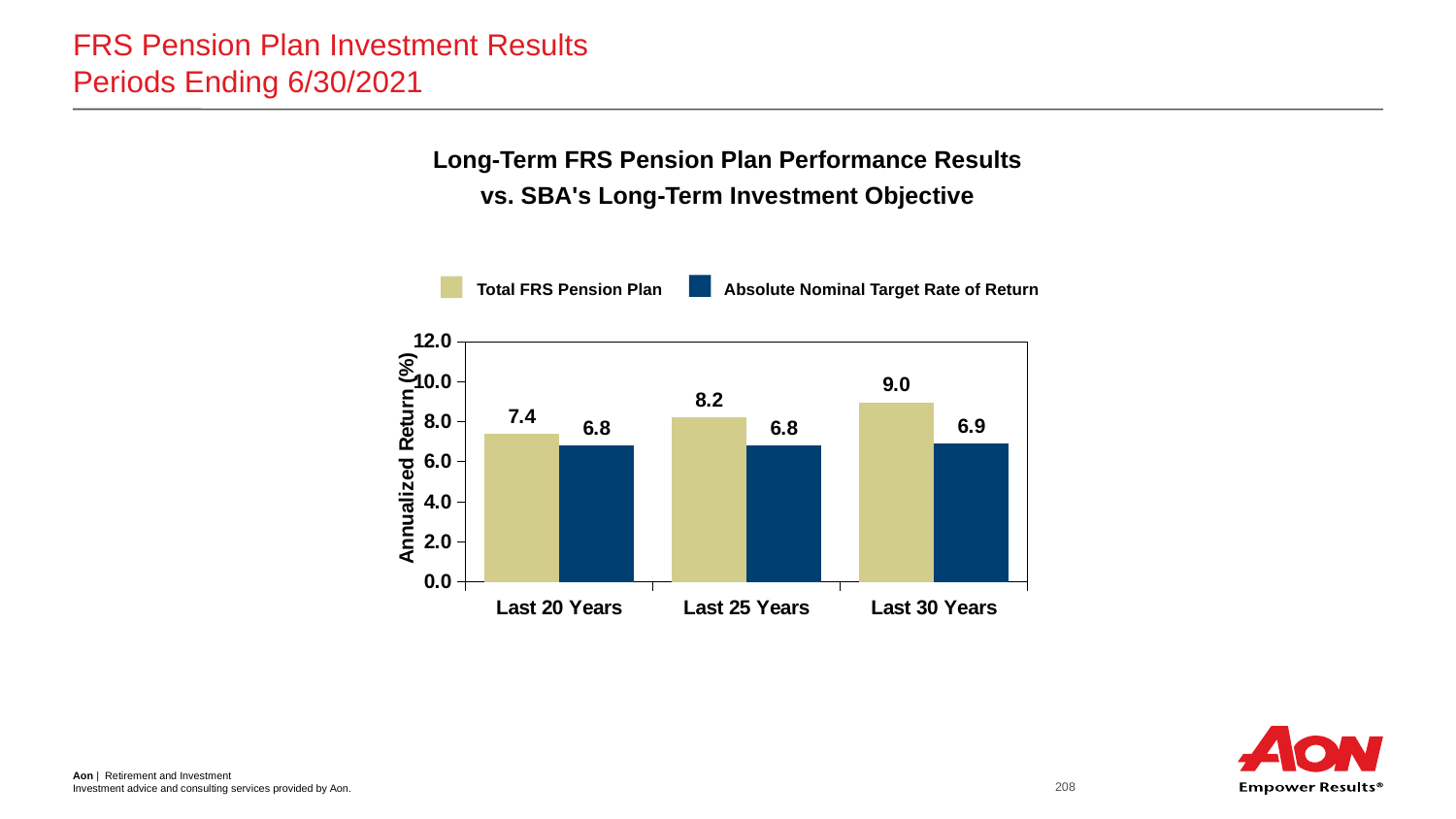
Do the Total FRS Pension Plan values rise or fall from Last 20 Years to Last 30 Years? rise What is the value for Absolute Nominal Target Rate of Return for Last 30 Years? 6.9 How many periods are shown on the x axis? 3 Which is larger for Last 25 Years: Total FRS Pension Plan or Absolute Nominal Target Rate of Return? Total FRS Pension Plan Which period has the highest Total FRS Pension Plan value? Last 30 Years Is the value for Total FRS Pension Plan for Last 30 Years greater or less than 8.0? greater Which period has the lowest Total FRS Pension Plan value? Last 20 Years What is the difference between Total FRS Pension Plan and Absolute Nominal Target Rate of Return for Last 30 Years? 2.1 What is the value for Total FRS Pension Plan for Last 25 Years? 8.2 What kind of chart is shown? bar chart What is the value for Total FRS Pension Plan for Last 20 Years? 7.4 How many series does the legend list? 2